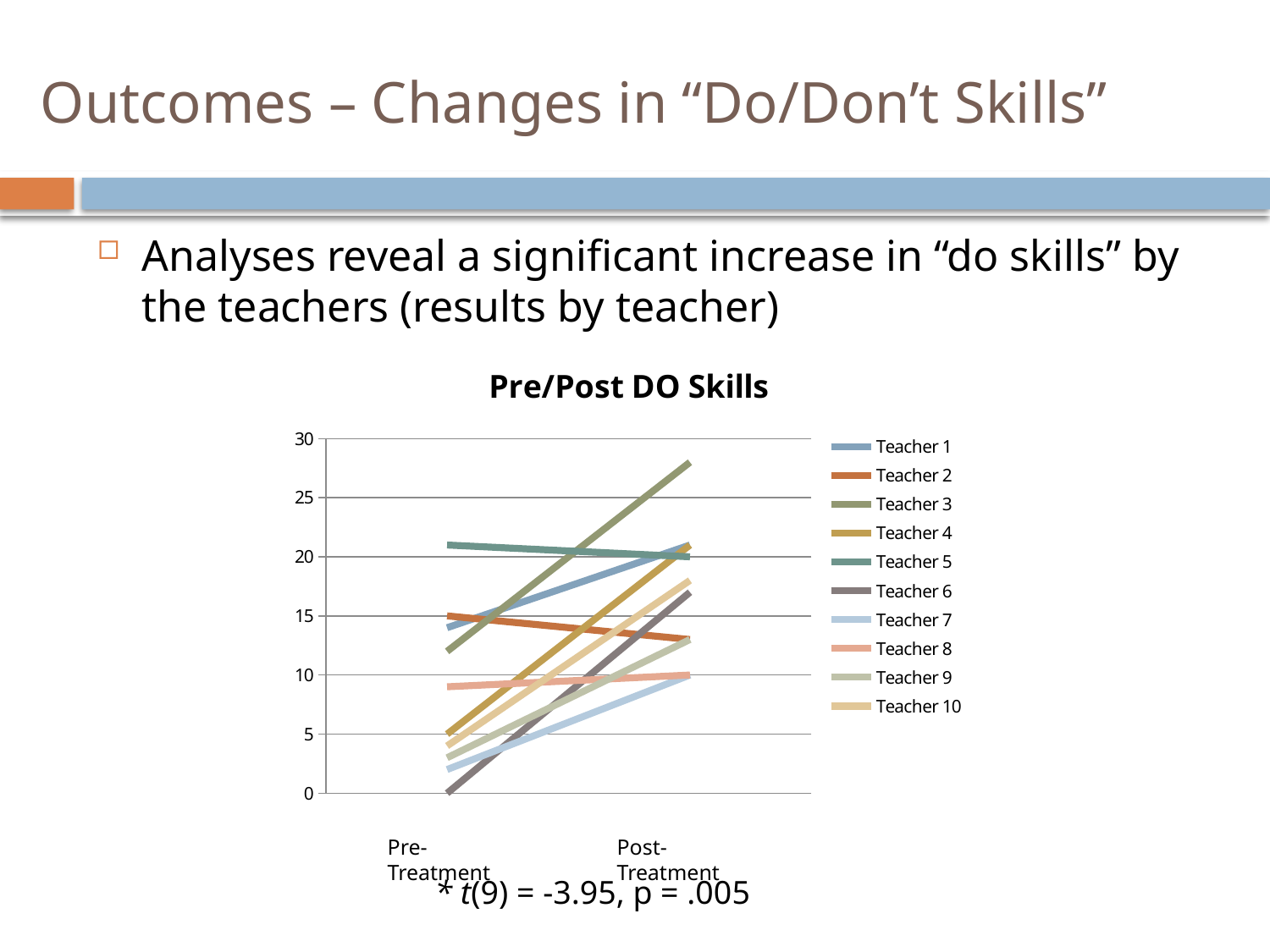
Which teacher has the highest Post-Treatment value? Teacher 3 What is the Pre-Treatment value for Teacher 6? 0 What kind of chart is shown on the slide? line chart Does the value for Teacher 2 rise or fall from Pre-Treatment to Post-Treatment? fall How many categories are shown on the x axis of the chart? 2 How many series does the legend of the chart list? 10 Is the Post-Treatment value for Teacher 10 greater or less than 15? greater What is the title of the chart? Pre/Post DO Skills Which is larger at Post-Treatment, the value for Teacher 3 or the value for Teacher 2? Teacher 3 Is the Pre-Treatment value for Teacher 7 greater or less than 5? less Is the Post-Treatment value for Teacher 3 greater or less than 25? greater Which teacher has the lowest Pre-Treatment value? Teacher 6